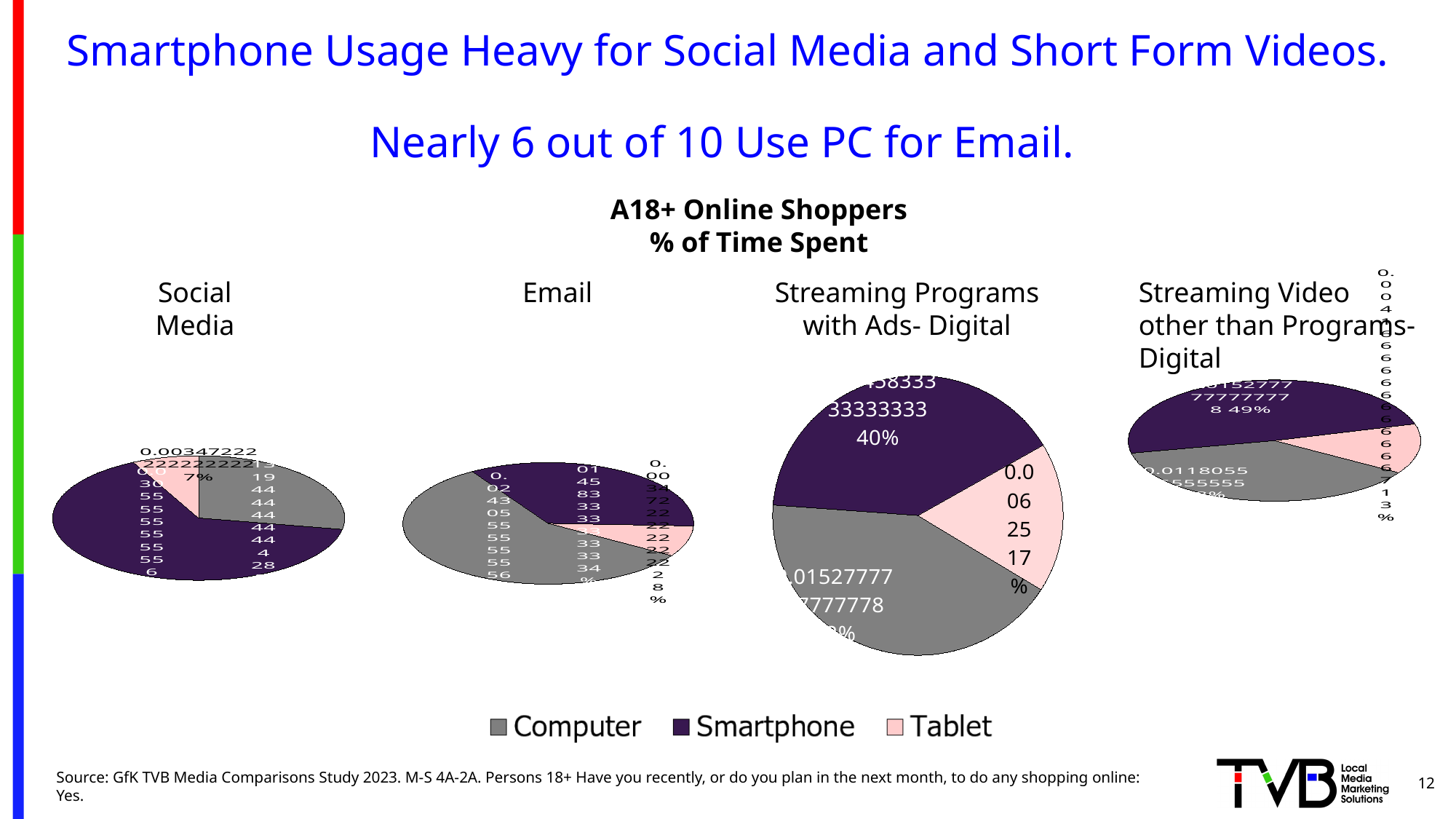
What kind of charts are shown on the slide? Pie charts In the Email pie chart, which device has the smallest share? Tablet In the Streaming Programs with Ads- Digital pie chart, what share of time spent is attributed to Smartphone? 40% How many series does the legend list? 3 In the Social Media pie chart, which is larger, the Smartphone share or the Computer share? Smartphone How many pie charts are on the slide? 4 In the Social Media pie chart, which device has the largest share? Smartphone In the Email pie chart, which device has the largest share? Computer What are the three series named in the legend? Computer, Smartphone, Tablet In the Social Media pie chart, what share of time spent is attributed to Tablet? 7% What is the overall title above the pie charts? A18+ Online Shoppers % of Time Spent In the Streaming Video other than Programs- Digital pie chart, which device has the smallest share? Tablet